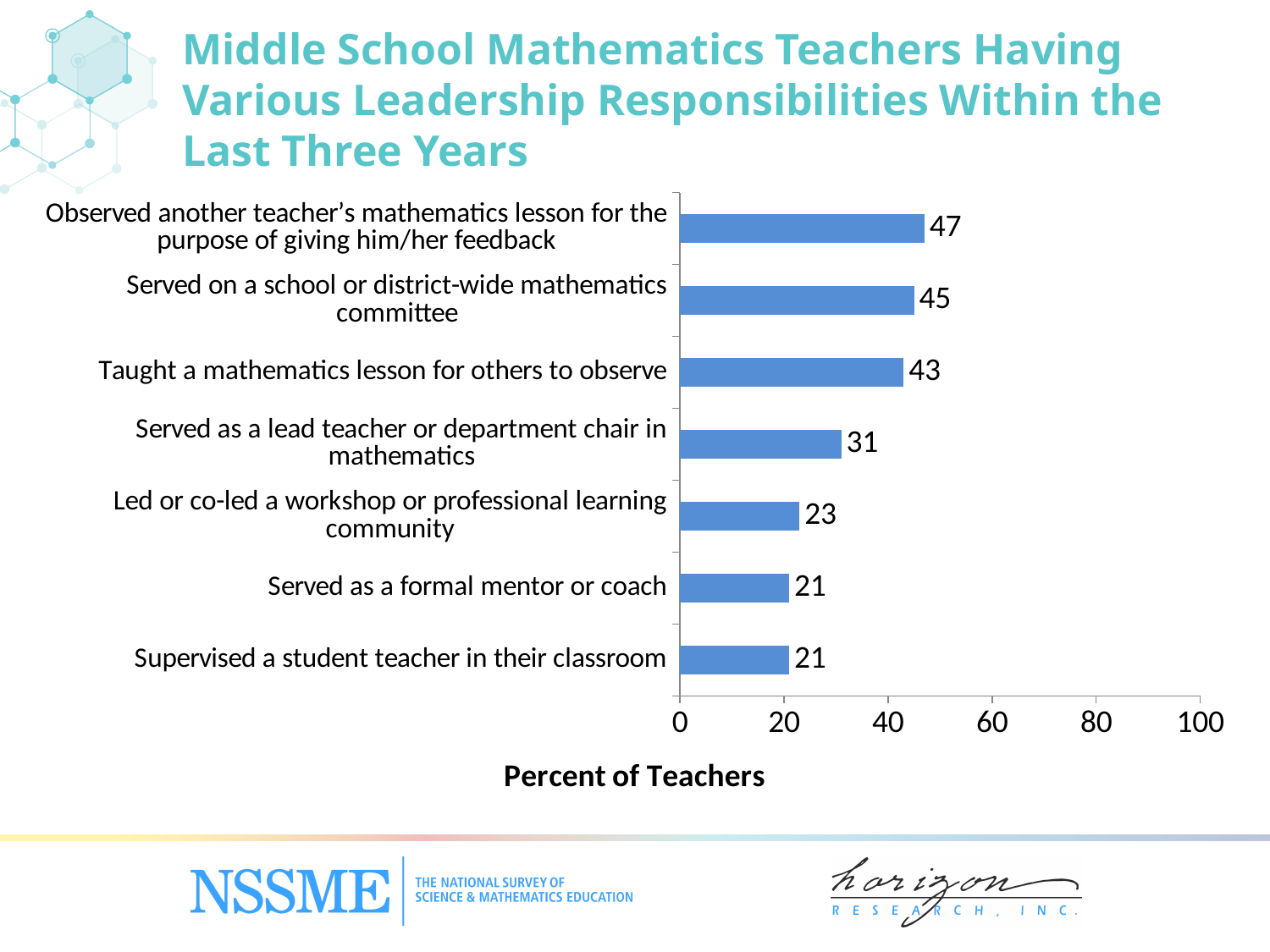
What is the difference in percent of teachers between taught a mathematics lesson for others to observe and served as a formal mentor or coach? 22 What is the maximum value shown on the horizontal axis? 100 What kind of chart is shown on the slide? Bar chart Is the value for served on a school or district-wide mathematics committee greater or less than 40? greater What percent of teachers served as a lead teacher or department chair in mathematics? 31 What is the label of the horizontal axis? Percent of Teachers Which is larger: the percent of teachers who served as a lead teacher or department chair in mathematics, or the percent who led or co-led a workshop or professional learning community? Served as a lead teacher or department chair in mathematics How many leadership responsibilities are shown in the chart? 7 What percent of teachers observed another teacher's mathematics lesson for the purpose of giving him/her feedback? 47 What percent of teachers led or co-led a workshop or professional learning community? 23 What percent of teachers served on a school or district-wide mathematics committee? 45 Which leadership responsibility has the highest percent of teachers? Observed another teacher's mathematics lesson for the purpose of giving him/her feedback